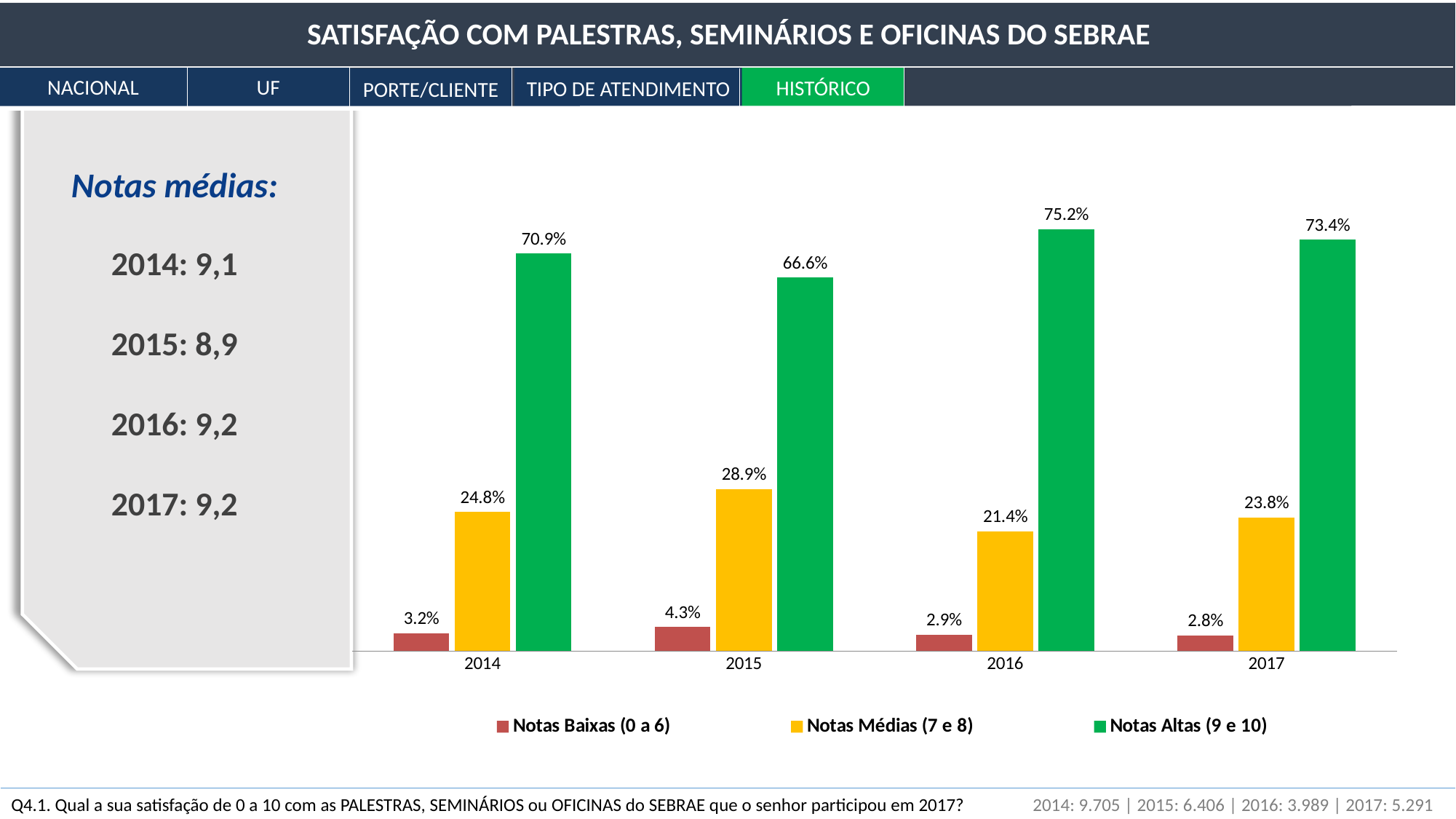
What is the difference between the Notas Altas (9 e 10) values for 2016 and 2015? 8.6% What is the value for Notas Médias (7 e 8) in 2015? 28.9% In which year is the Notas Baixas (0 a 6) value lowest? 2017 What colour are the Notas Altas (9 e 10) bars? Green What is the value for Notas Altas (9 e 10) in 2016? 75.2% What kind of chart is shown? Bar chart How many series does the legend list? 3 How many years are shown on the x axis? 4 Does the Notas Altas (9 e 10) value rise or fall from 2014 to 2015? Fall Which is larger: Notas Médias (7 e 8) in 2014 or in 2017? 2014 In which year is the Notas Altas (9 e 10) value highest? 2016 What is the value for Notas Baixas (0 a 6) in 2017? 2.8%